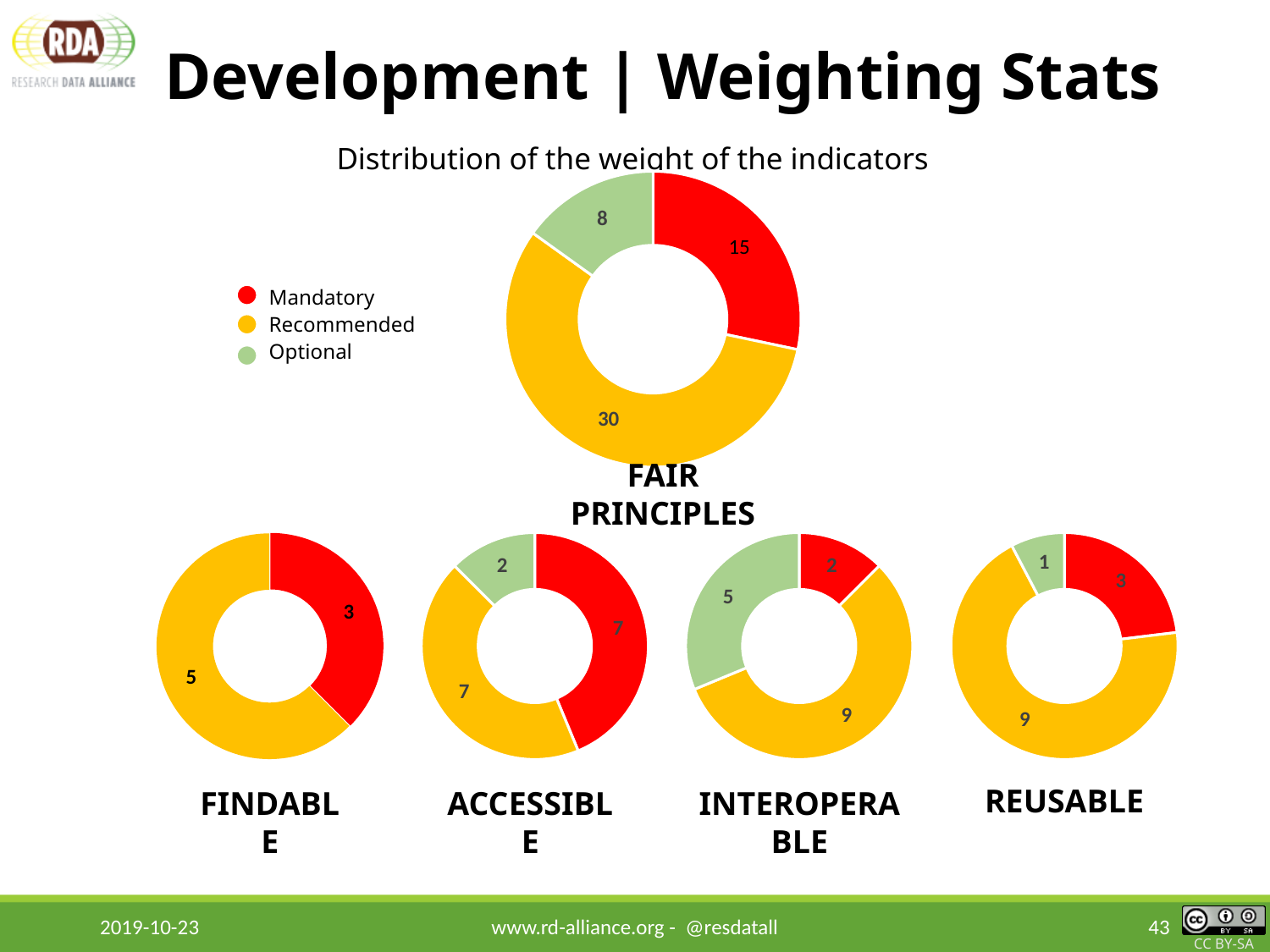
In the FAIR PRINCIPLES chart, what is the difference between the Recommended and Mandatory values? 15 In the REUSABLE chart, what is the value for Mandatory? 3 In the FINDABLE chart, which is larger, Mandatory or Recommended? Recommended What kind of chart is the FAIR PRINCIPLES chart? Doughnut chart In the FAIR PRINCIPLES chart, which category has the smallest value? Optional In the FAIR PRINCIPLES chart, what is the value for Recommended? 30 In the FINDABLE chart, what is the value for Recommended? 5 In the FAIR PRINCIPLES chart, what is the value for Mandatory? 15 In the ACCESSIBLE chart, what is the value for Optional? 2 How many series does the legend list? 3 In the INTEROPERABLE chart, which category has the largest value? Recommended In the INTEROPERABLE chart, what is the value for Optional? 5